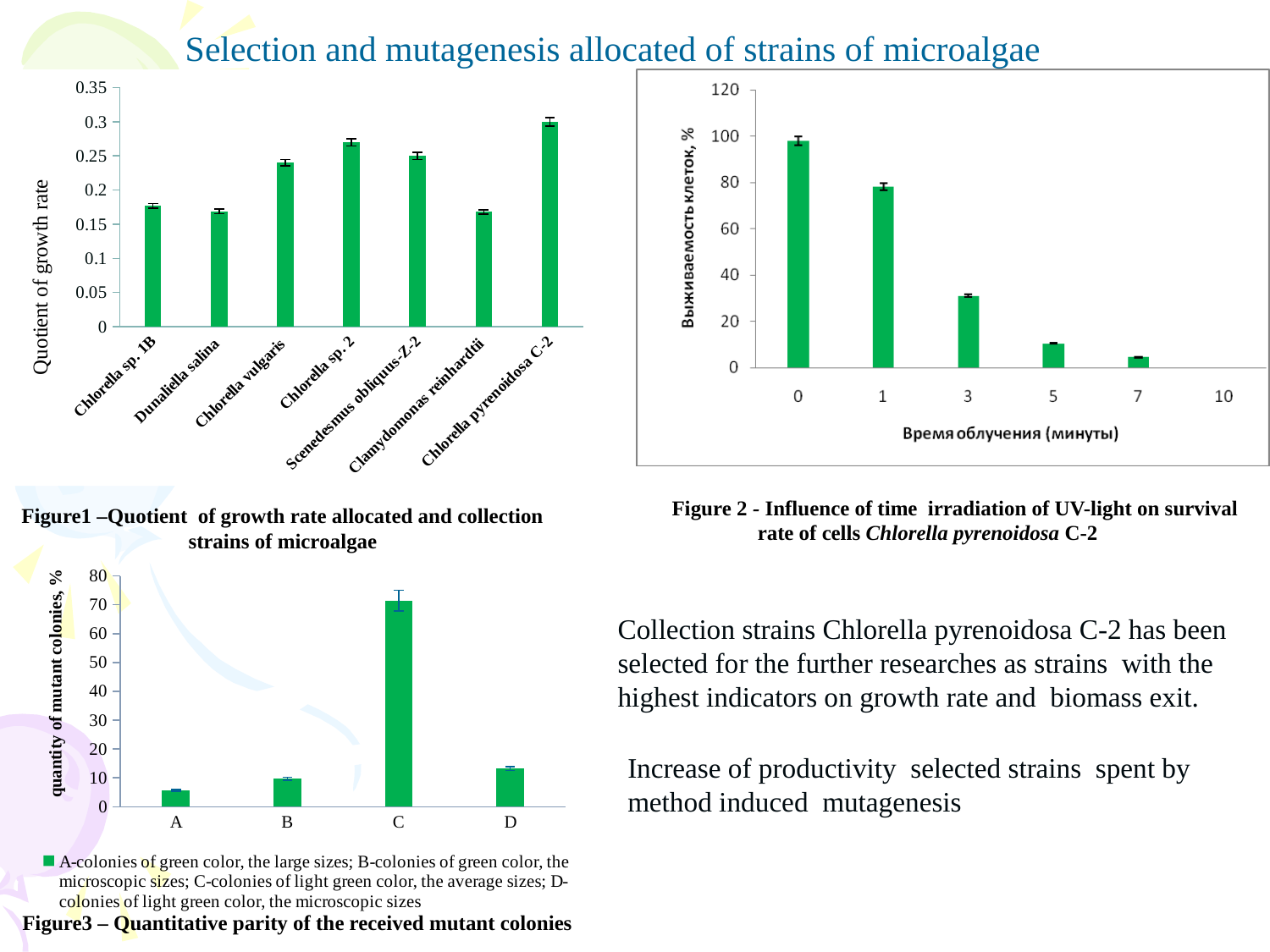
In Figure 2 (survival rate of Chlorella pyrenoidosa C-2), is the survival rate at 1 minute greater or less than 60? greater In Figure 1 (Quotient of growth rate), is the value for Chlorella sp. 1B greater or less than 0.2? less In Figure 1 (Quotient of growth rate), is the value for Chlorella vulgaris greater or less than 0.2? greater In Figure 1 (Quotient of growth rate), how many strains of microalgae are plotted? 7 In Figure 1 (Quotient of growth rate), which has the larger quotient of growth rate, Chlorella vulgaris or Dunaliella salina? Chlorella vulgaris In Figure 1 (Quotient of growth rate), which strain has the highest quotient of growth rate? Chlorella pyrenoidosa C-2 In Figure 2 (survival rate of Chlorella pyrenoidosa C-2), at which irradiation time is the survival rate highest? 0 In Figure 2 (survival rate of Chlorella pyrenoidosa C-2), does the survival rate rise or fall as irradiation time increases? fall In Figure 3 (Quantitative parity of the received mutant colonies), which colony type has the highest quantity of mutant colonies? C In Figure 3 (Quantitative parity of the received mutant colonies), what kind of chart is shown? bar chart In Figure 3 (Quantitative parity of the received mutant colonies), which colony type has the lowest quantity of mutant colonies? A